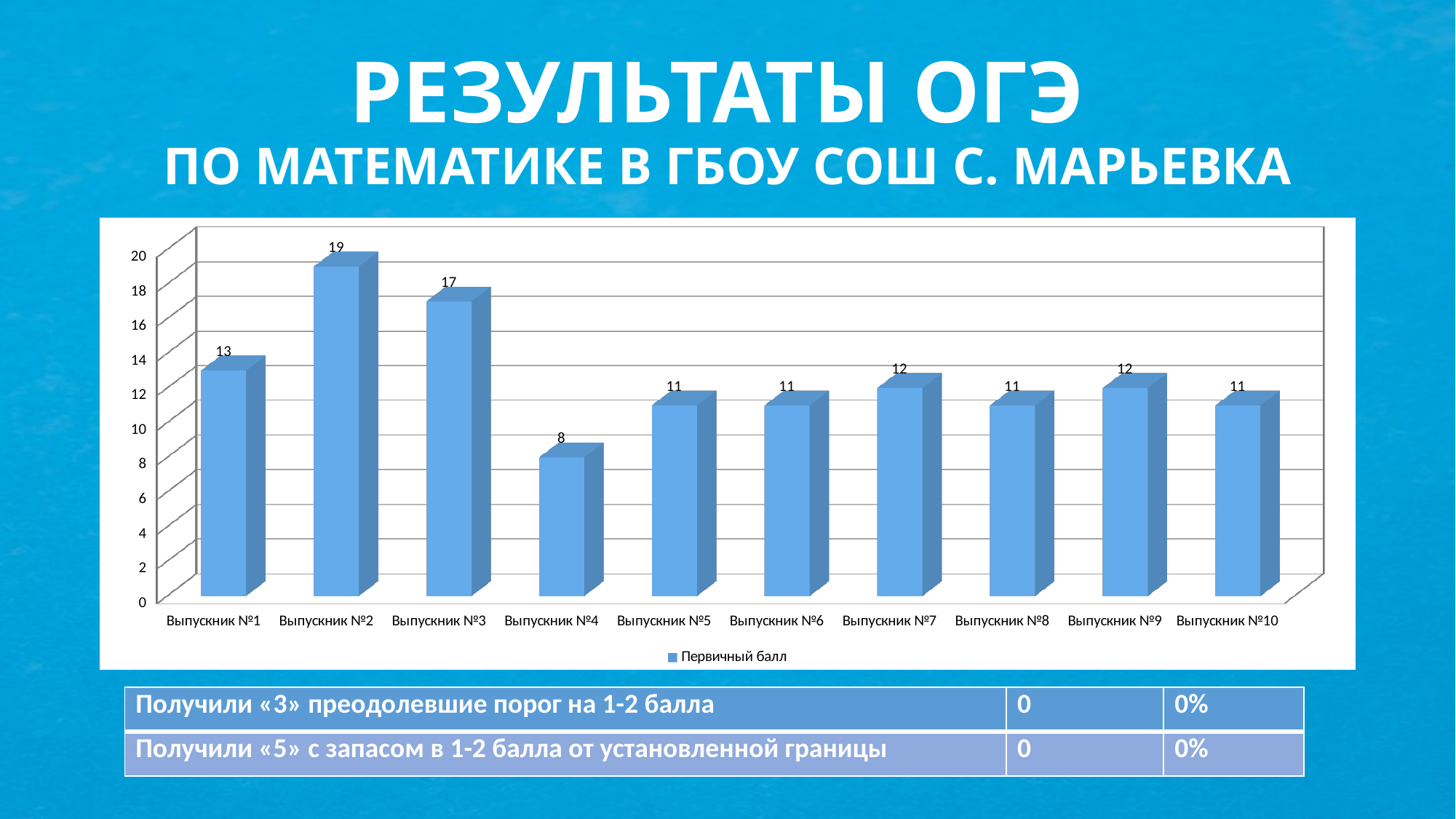
How many series does the legend list? 1 What kind of chart is shown on the slide? bar chart Which category has the highest value? Выпускник №2 What is the difference between the values for Выпускник №2 and Выпускник №3? 2 Which is larger, the value for Выпускник №1 or the value for Выпускник №9? Выпускник №1 What is the value for Выпускник №2? 19 Which category has the lowest value? Выпускник №4 What is the value for Выпускник №4? 8 What is the value for Выпускник №7? 12 What is the difference between the values for Выпускник №1 and Выпускник №4? 5 How many categories are shown on the x axis? 10 What is the name of the series in the legend? Первичный балл